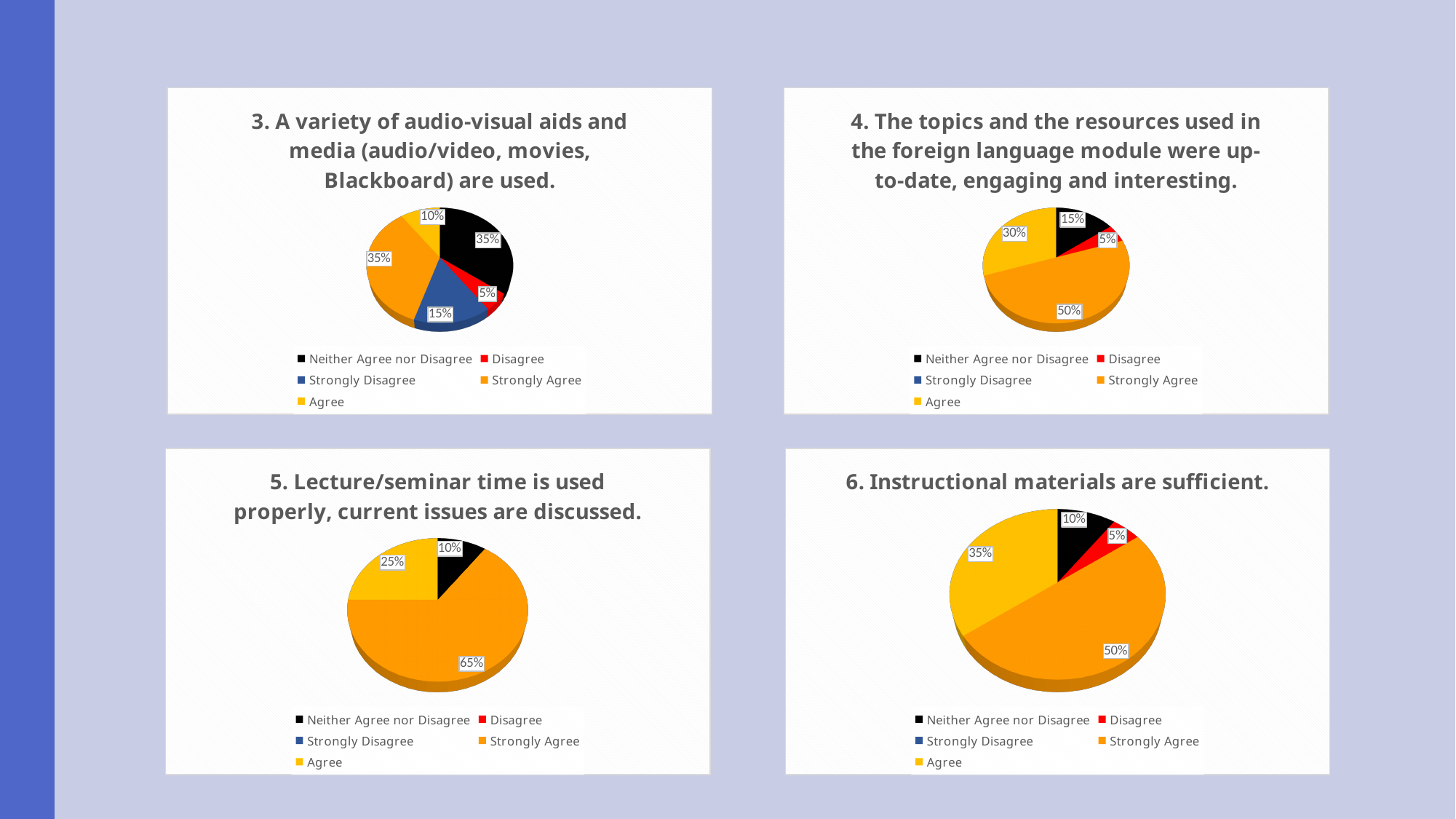
In the chart titled "3. A variety of audio-visual aids and media (audio/video, movies, Blackboard) are used.", what share is Strongly Disagree? 15% In the chart titled "6. Instructional materials are sufficient.", which response has the largest slice? Strongly Agree In the chart titled "6. Instructional materials are sufficient.", what share is Agree? 35% In the chart titled "5. Lecture/seminar time is used properly, current issues are discussed.", what is the difference between the Strongly Agree and Agree shares? 40% In the chart titled "3. A variety of audio-visual aids and media (audio/video, movies, Blackboard) are used.", what share is Agree? 10% What kind of chart is used in the chart titled "5. Lecture/seminar time is used properly, current issues are discussed."? Pie chart In the chart titled "4. The topics and the resources used in the foreign language module were up-to-date, engaging and interesting.", what colour is the Agree slice? Yellow In the chart titled "6. Instructional materials are sufficient.", which is larger, Neither Agree nor Disagree or Disagree? Neither Agree nor Disagree In the chart titled "4. The topics and the resources used in the foreign language module were up-to-date, engaging and interesting.", which response has the smallest slice? Disagree How many entries does the legend list in the chart titled "3. A variety of audio-visual aids and media (audio/video, movies, Blackboard) are used."? 5